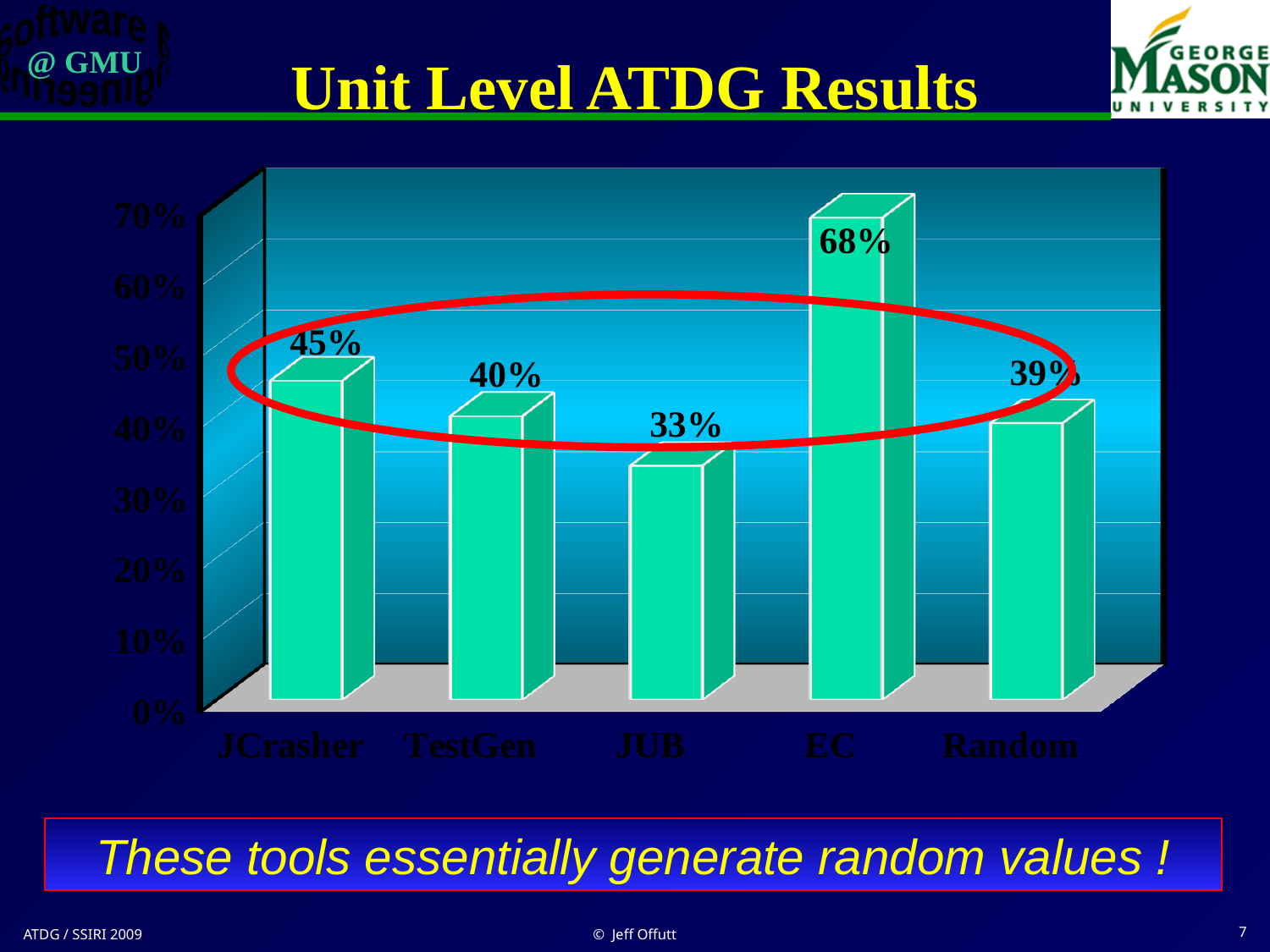
What is the title of the chart? Unit Level ATDG Results Which tool has the lowest value? JUB How many tools are shown on the x axis? 5 What is the value for EC? 68% What kind of chart is shown on the slide? bar chart Is the value for EC greater or less than 60%? greater What is the value for JUB? 33% Which tool has the highest value? EC What is the difference between the values for EC and JCrasher? 23% What is the value for Random? 39% Which is larger, the value for TestGen or the value for Random? TestGen What is the value for JCrasher? 45%